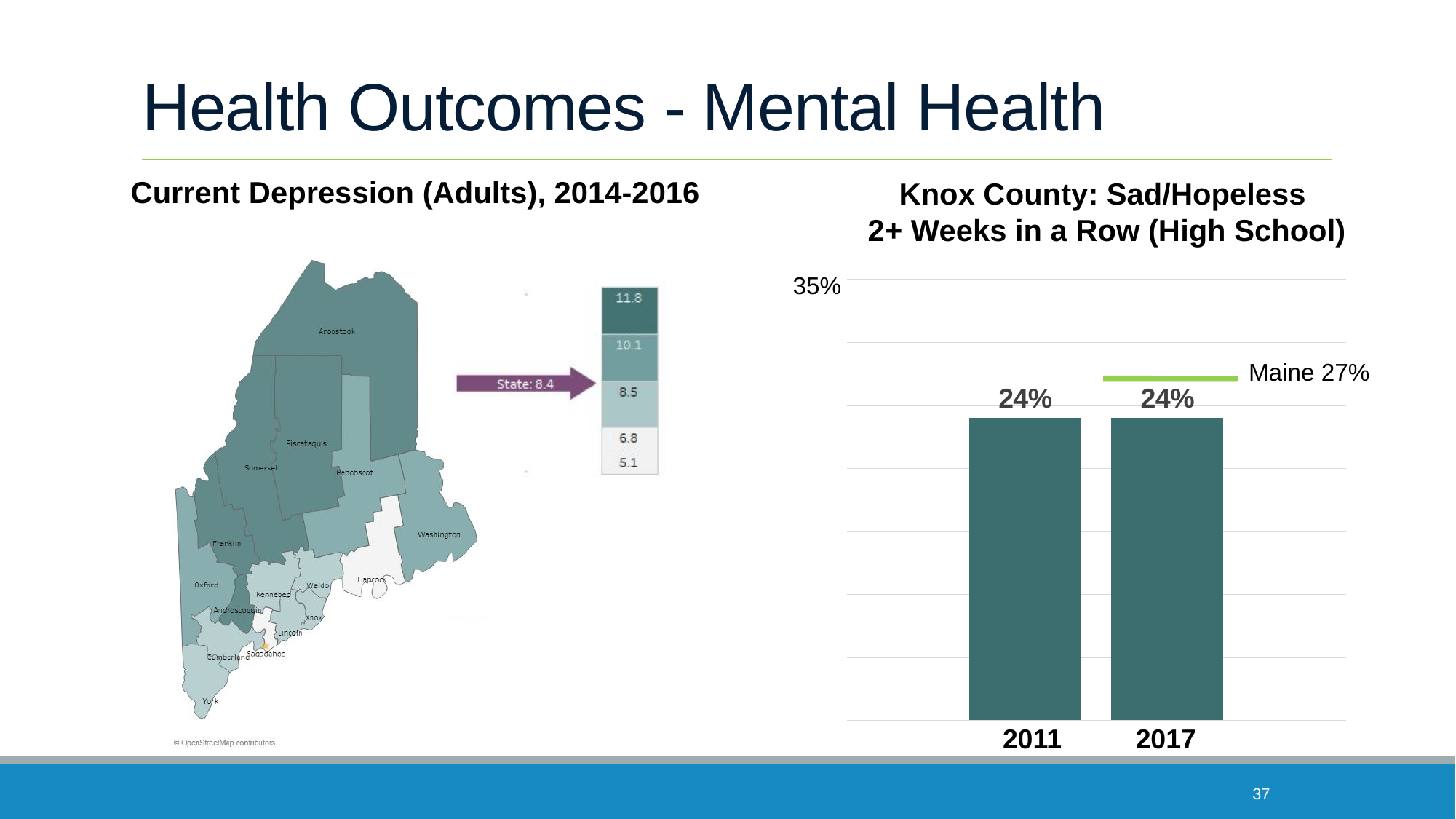
What kind of chart is the Knox County: Sad/Hopeless 2+ Weeks in a Row (High School) chart? bar chart On the Knox County: Sad/Hopeless 2+ Weeks in a Row (High School) chart, what is the Maine value shown by the reference line? 27% On the Knox County: Sad/Hopeless 2+ Weeks in a Row (High School) chart, what is the value for 2011? 24% On the Knox County: Sad/Hopeless 2+ Weeks in a Row (High School) chart, how many years are plotted as bars? 2 On the Knox County: Sad/Hopeless 2+ Weeks in a Row (High School) chart, is the 2017 Knox County value greater or less than the Maine value? less On the Knox County: Sad/Hopeless 2+ Weeks in a Row (High School) chart, what is the value for 2017? 24% On the Current Depression (Adults), 2014-2016 map, what is the highest value shown in the colour legend? 11.8 On the Current Depression (Adults), 2014-2016 map, what is the state value shown by the arrow? 8.4 On the Knox County: Sad/Hopeless 2+ Weeks in a Row (High School) chart, is the value for 2011 greater or less than 35%? less On the Knox County: Sad/Hopeless 2+ Weeks in a Row (High School) chart, what is the highest value labelled on the vertical axis? 35% On the Knox County: Sad/Hopeless 2+ Weeks in a Row (High School) chart, do the values rise, fall, or stay the same from 2011 to 2017? stay the same On the Knox County: Sad/Hopeless 2+ Weeks in a Row (High School) chart, what is the difference between the 2011 and 2017 values? 0%